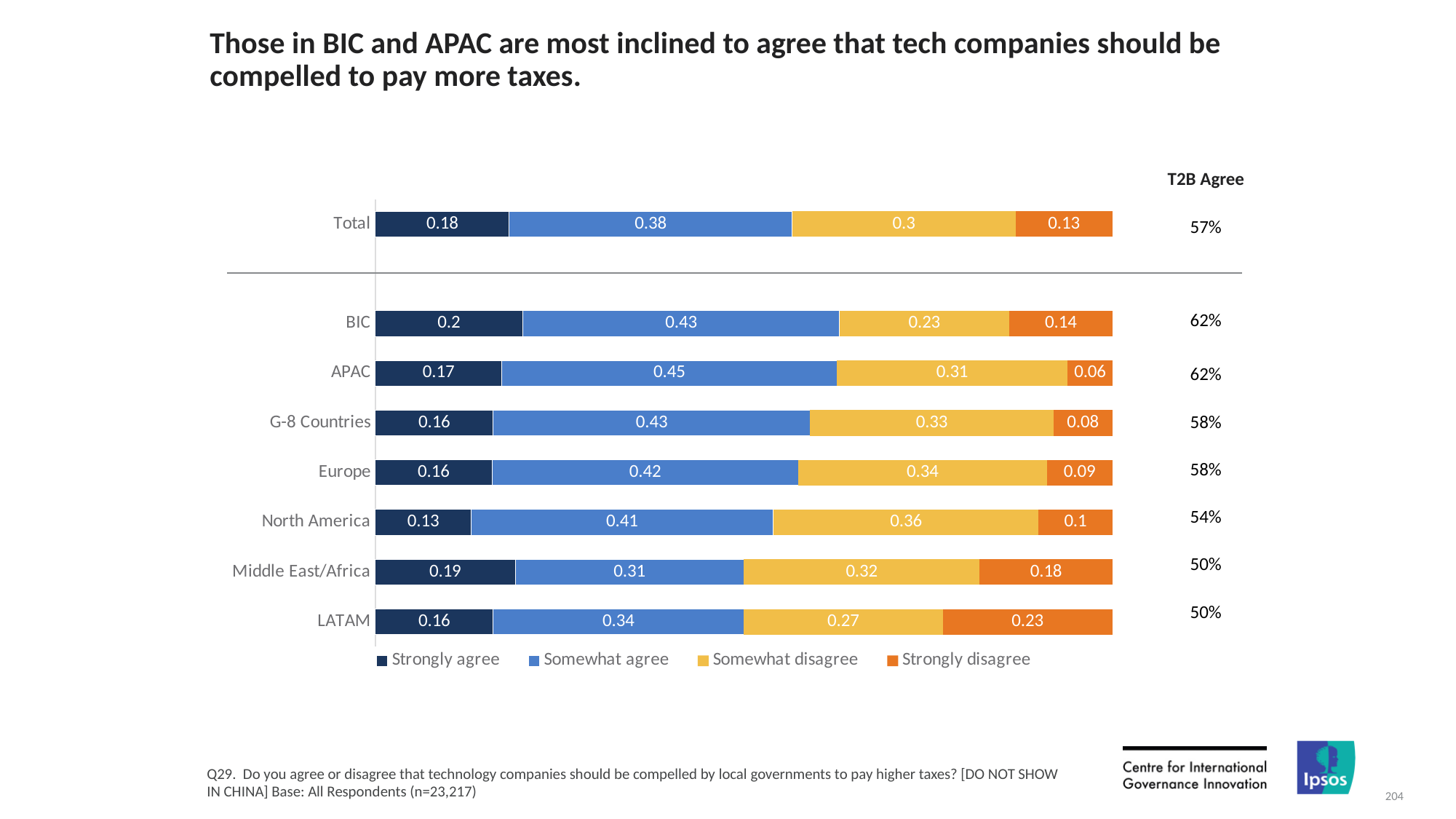
What kind of chart is shown on the slide? Stacked bar chart What is the Somewhat disagree value for North America? 0.36 Which category has the highest Strongly disagree value? LATAM What is the T2B Agree value shown for Middle East/Africa? 50% How many categories are shown on the chart, including Total? 8 Which category has the lowest Strongly agree value? North America How many series does the legend list? 4 Which is larger, the Somewhat disagree value for Europe or for BIC? Europe What is the difference between the Somewhat agree values for APAC and Middle East/Africa? 0.14 What is the Strongly agree value for BIC? 0.2 What is the Somewhat agree value for APAC? 0.45 What is the Strongly disagree value for LATAM? 0.23